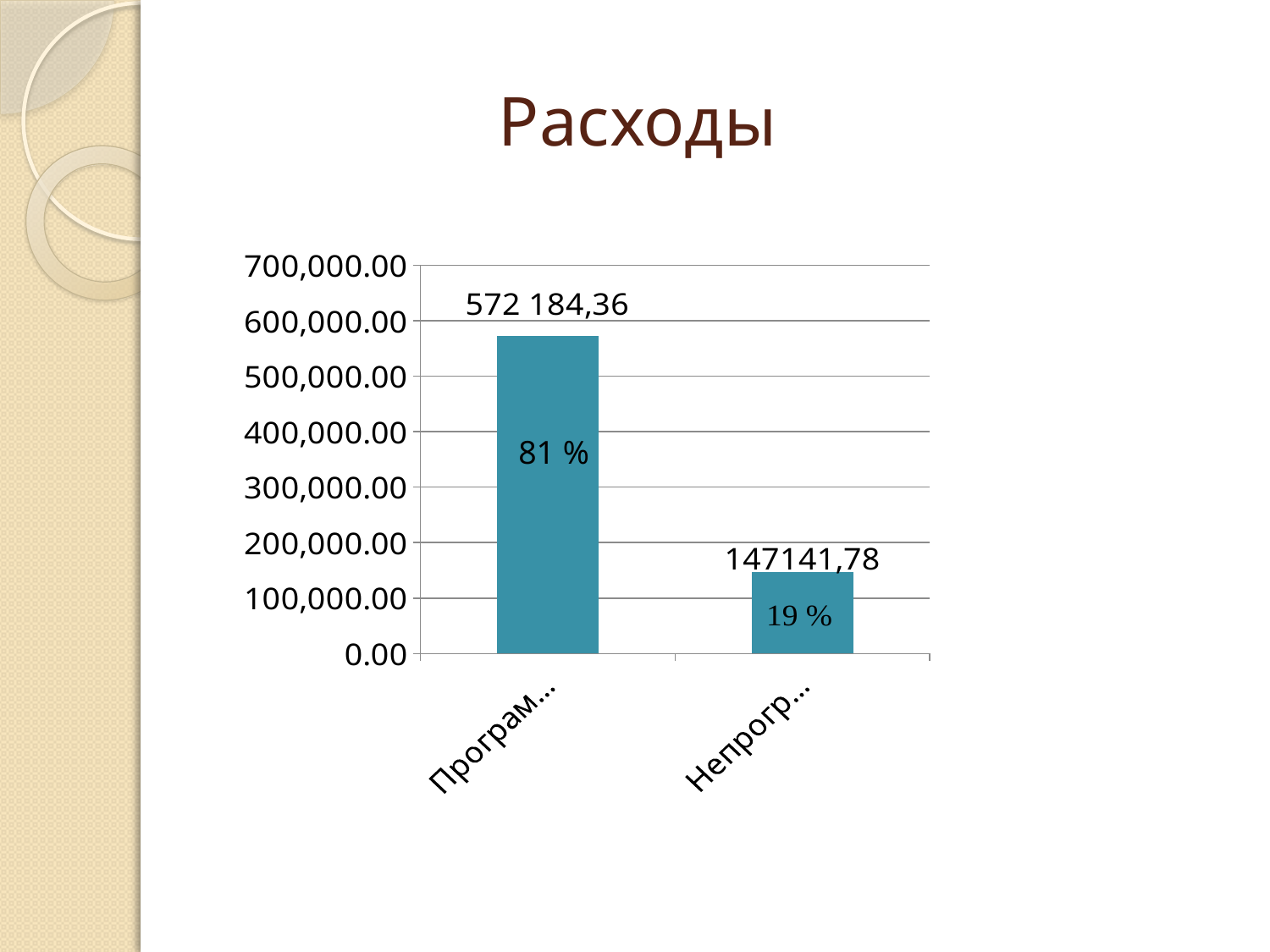
What is the title of the chart on the slide? Расходы What percentage is printed inside the left bar ('Програм…')? 81 % Which bar is the highest in the chart? Програм… (the left bar) Is the value for the left bar ('Програм…') greater or less than 500,000.00? greater What value is labelled on the first (left) bar, 'Програм…'? 572 184,36 What value is labelled on the second (right) bar, 'Непрогр…'? 147141,78 What kind of chart is shown on the slide? bar chart How many bars does the chart show? 2 Is the value for the right bar ('Непрогр…') greater or less than 200,000.00? less What percentage is printed inside the right bar ('Непрогр…')? 19 % Which bar is the lowest in the chart? Непрогр… (the right bar) Which is larger, the value for 'Програм…' or the value for 'Непрогр…'? Програм…